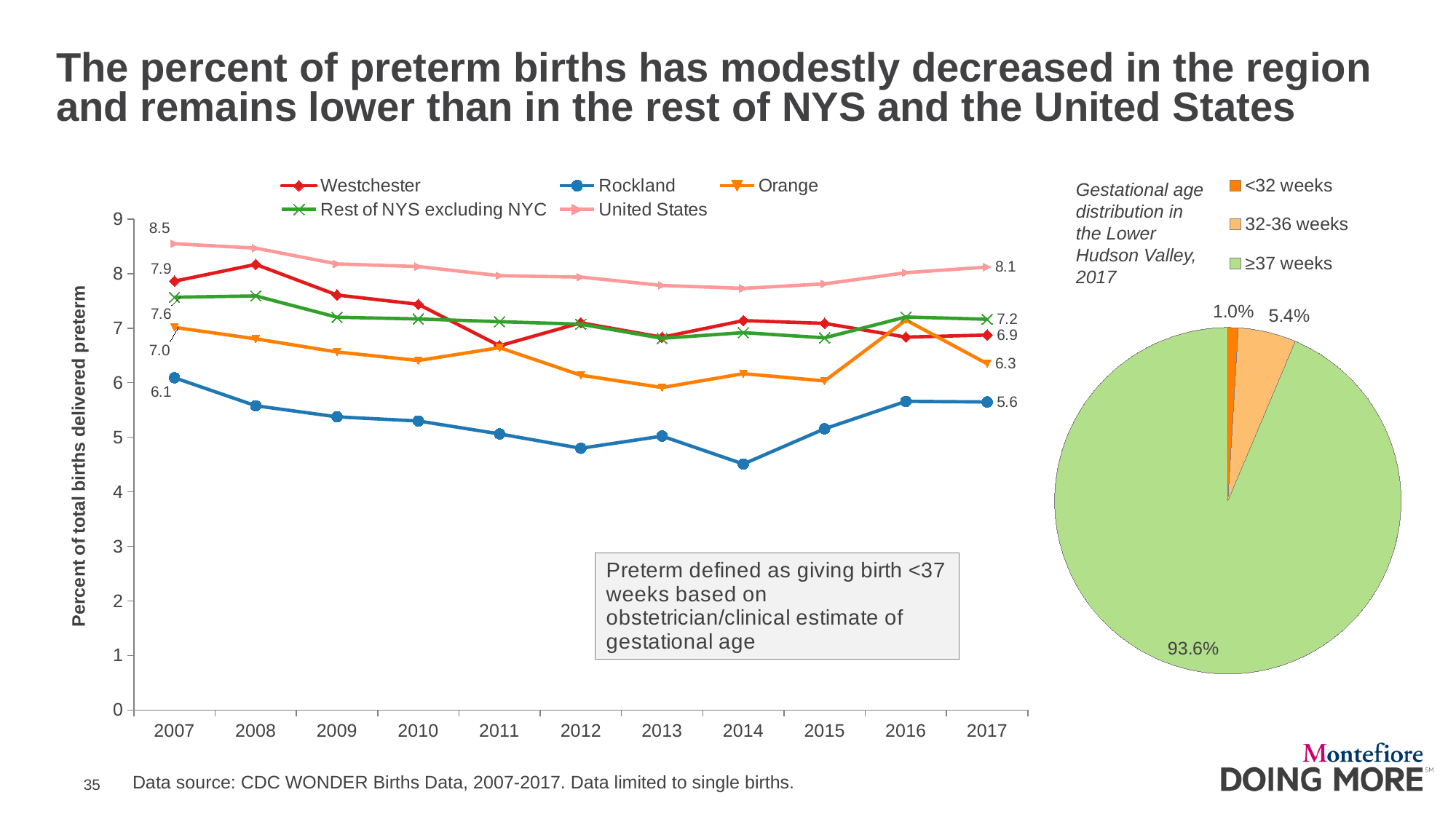
In the pie chart of gestational age distribution in the Lower Hudson Valley, 2017, what share of births were ≥37 weeks? 93.6% In the line chart, which series had the lowest percent of preterm births in 2017? Rockland What kind of chart is the chart on the left of the slide? Line chart In the line chart, what was the percent of preterm births for Rockland in 2017? 5.6 In the line chart, by how much did Westchester's percent of preterm births decrease from 2007 to 2017? 1.0 In the line chart, is the value for Rockland in 2014 greater or less than 5? less In the pie chart of gestational age distribution, which category has the smallest share? <32 weeks In the line chart, what was the percent of preterm births for Orange in 2017? 6.3 How many series does the legend of the line chart list? 5 In the line chart, which had a higher percent of preterm births in 2017, Westchester or Orange? Westchester In the line chart, what was the percent of preterm births for the United States in 2007? 8.5 How many years are shown on the x axis of the line chart? 11